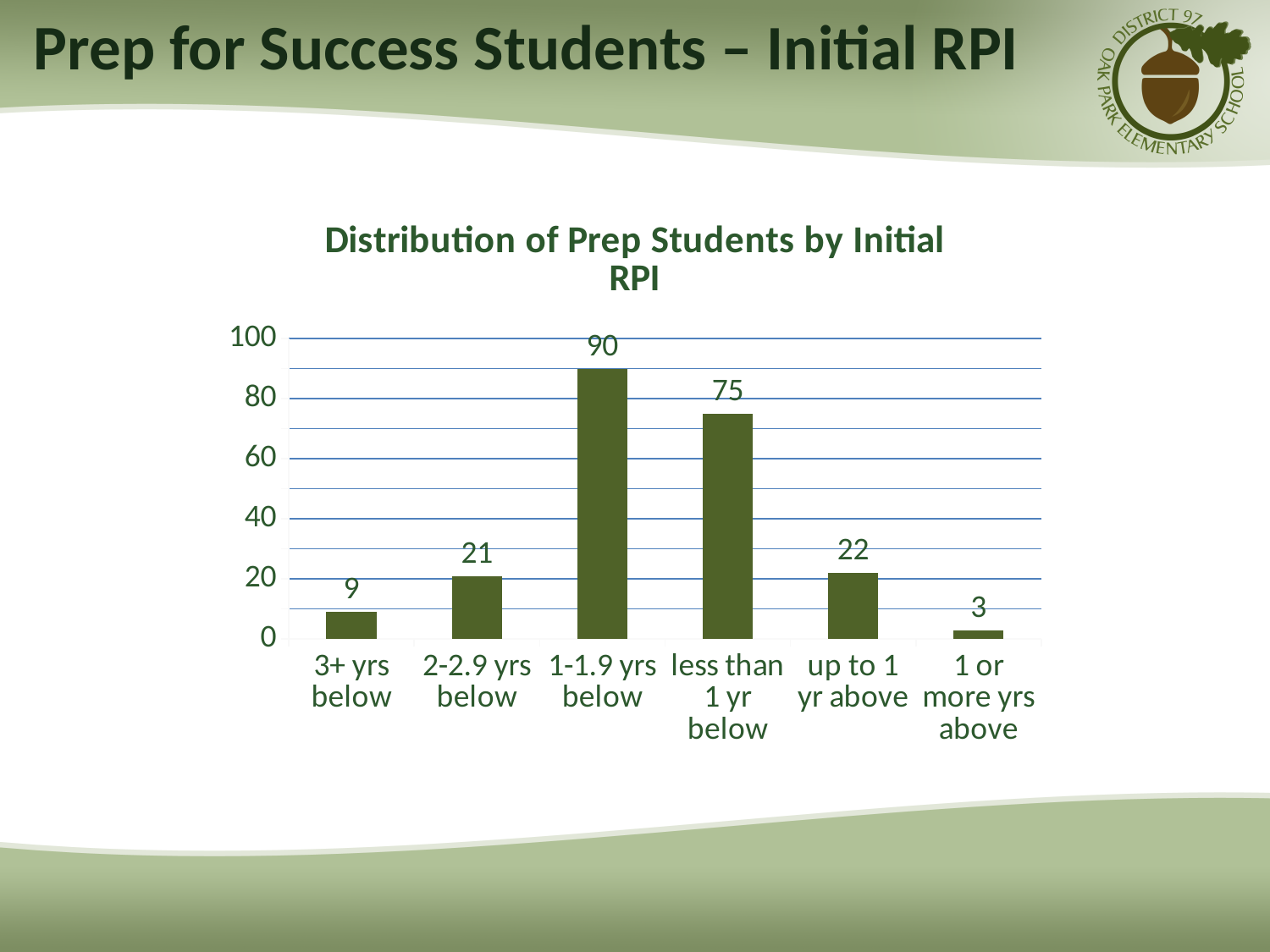
What is the value for the '3+ yrs below' category? 9 What is the value for the '1-1.9 yrs below' category? 90 How many categories are shown on the x axis? 6 Which category has the highest value? 1-1.9 yrs below Which category has the lowest value? 1 or more yrs above What is the difference between the values for '2-2.9 yrs below' and '3+ yrs below'? 12 What is the value for the 'up to 1 yr above' category? 22 What kind of chart is shown on the slide? bar chart What is the title of the chart? Distribution of Prep Students by Initial RPI Is the value for 'less than 1 yr below' greater or less than 60? greater Which is larger, the value for '2-2.9 yrs below' or the value for 'up to 1 yr above'? up to 1 yr above What is the difference between the values for '1-1.9 yrs below' and 'less than 1 yr below'? 15